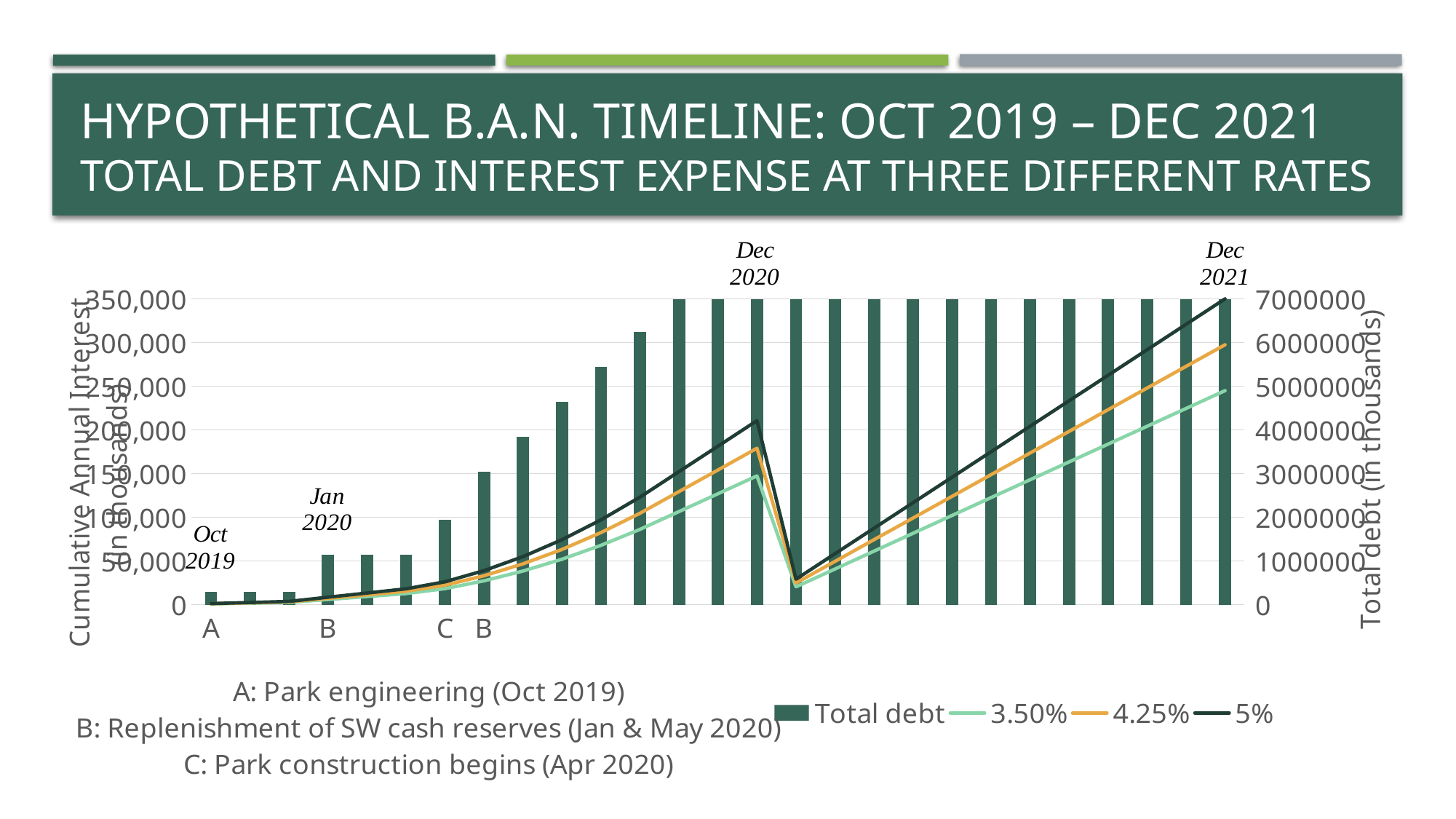
Is the value of the 3.50% line at Dec 2020 greater or less than 200,000? less Which interest-rate line is highest at Dec 2021? 5% Which interest-rate line is lowest at Dec 2021? 3.50% How many series does the legend list? 4 Which series is plotted as bars? Total debt Is the value of the 4.25% line at Dec 2021 greater or less than 250,000? greater Is the value of the 5% line at Dec 2020 greater or less than 150,000? greater At Dec 2020, which line is higher, the 4.25% line or the 3.50% line? 4.25% What kind of chart is shown on the slide? A combined bar and line chart According to the annotation, what event does label A on the chart mark? Park engineering (Oct 2019) Between Oct 2019 and Dec 2020, does the 5% line rise or fall? rise